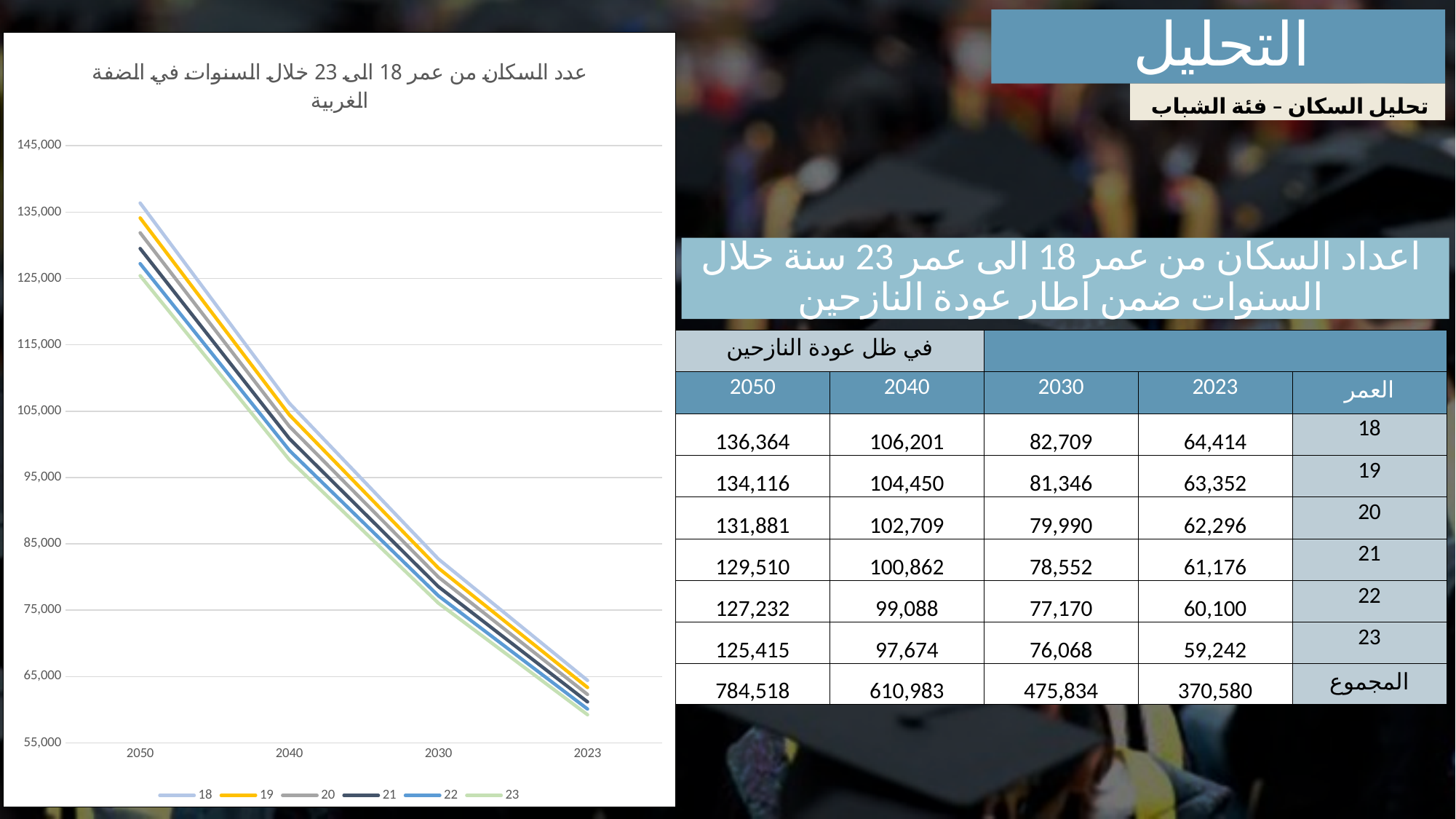
Do the values rise or fall along the x axis from 2050 to 2023? fall What kind of chart is shown on the left of the slide? line chart Is the value for series 18 at 2030 greater or less than 85,000? less At 2050, which series has the larger value, 18 or 23? 18 Is the value for series 18 at 2050 greater or less than 135,000? greater How many points are on the x axis of the chart? 4 Which series has the lowest values across the chart? 23 How many series does the chart legend list? 6 What colour is the line for series 19 in the chart? yellow Is the value for series 23 at 2023 greater or less than 65,000? less Which series has the highest values across the chart? 18